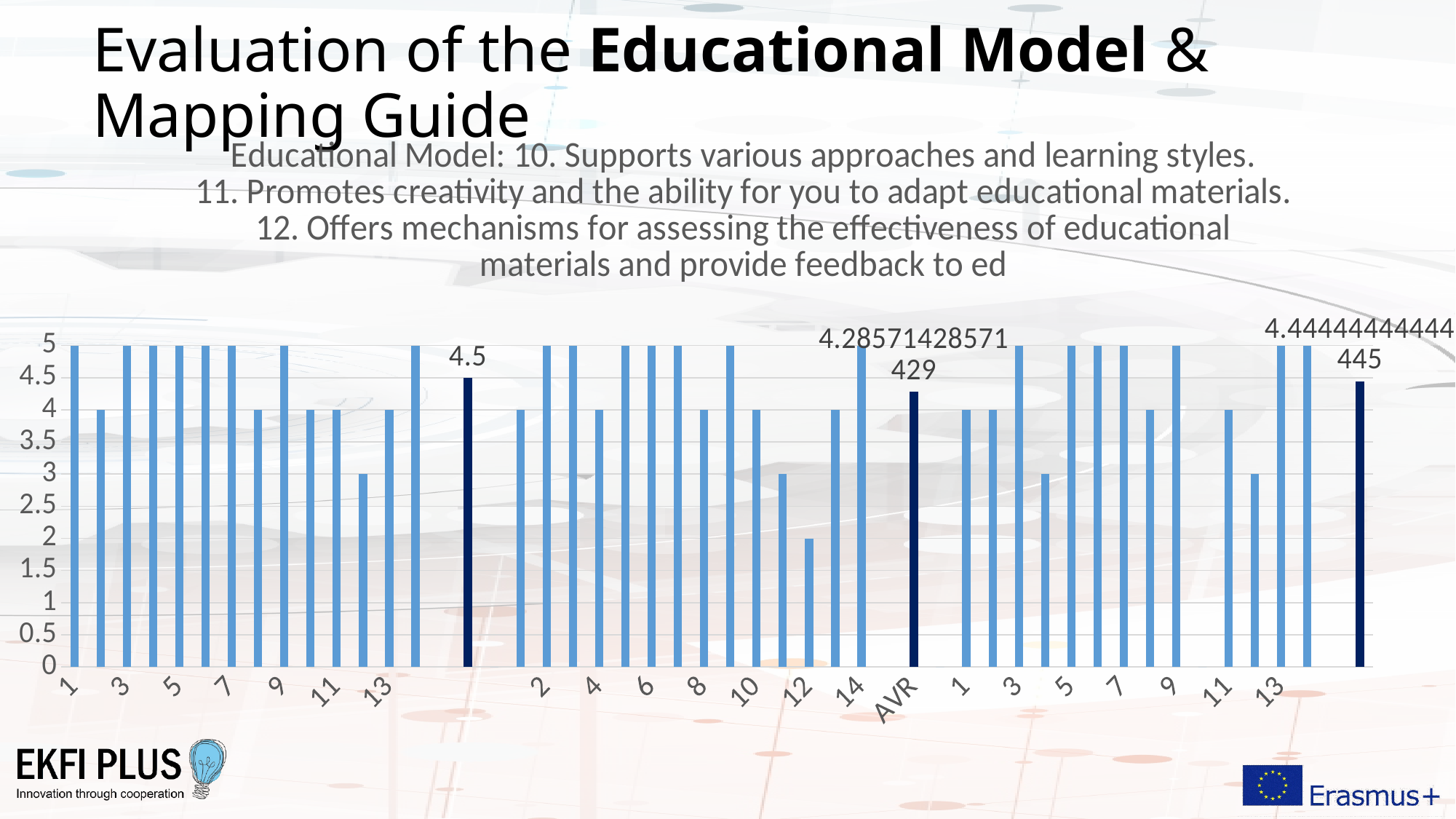
What is the highest value shown on the vertical axis? 5 What value is printed on the middle AVR bar? 4.28571428571429 In the middle group of bars, what is the value for category 12? 2 Is the middle AVR bar's value greater or less than 4.5? less Which of the three AVR bars has the lowest value? the middle AVR bar, 4.28571428571429 Which of the three AVR bars has the highest value? the first (left-most) AVR bar, 4.5 How many dark-blue AVR bars are shown in the chart? 3 Which is larger, the first AVR value or the right-most AVR value? the first AVR value (4.5) What value is printed on the first (left-most) AVR bar? 4.5 What kind of chart is shown on the slide? bar chart Is the right-most AVR bar's value greater or less than 4? greater What value is printed on the right-most AVR bar? 4.44444444444445